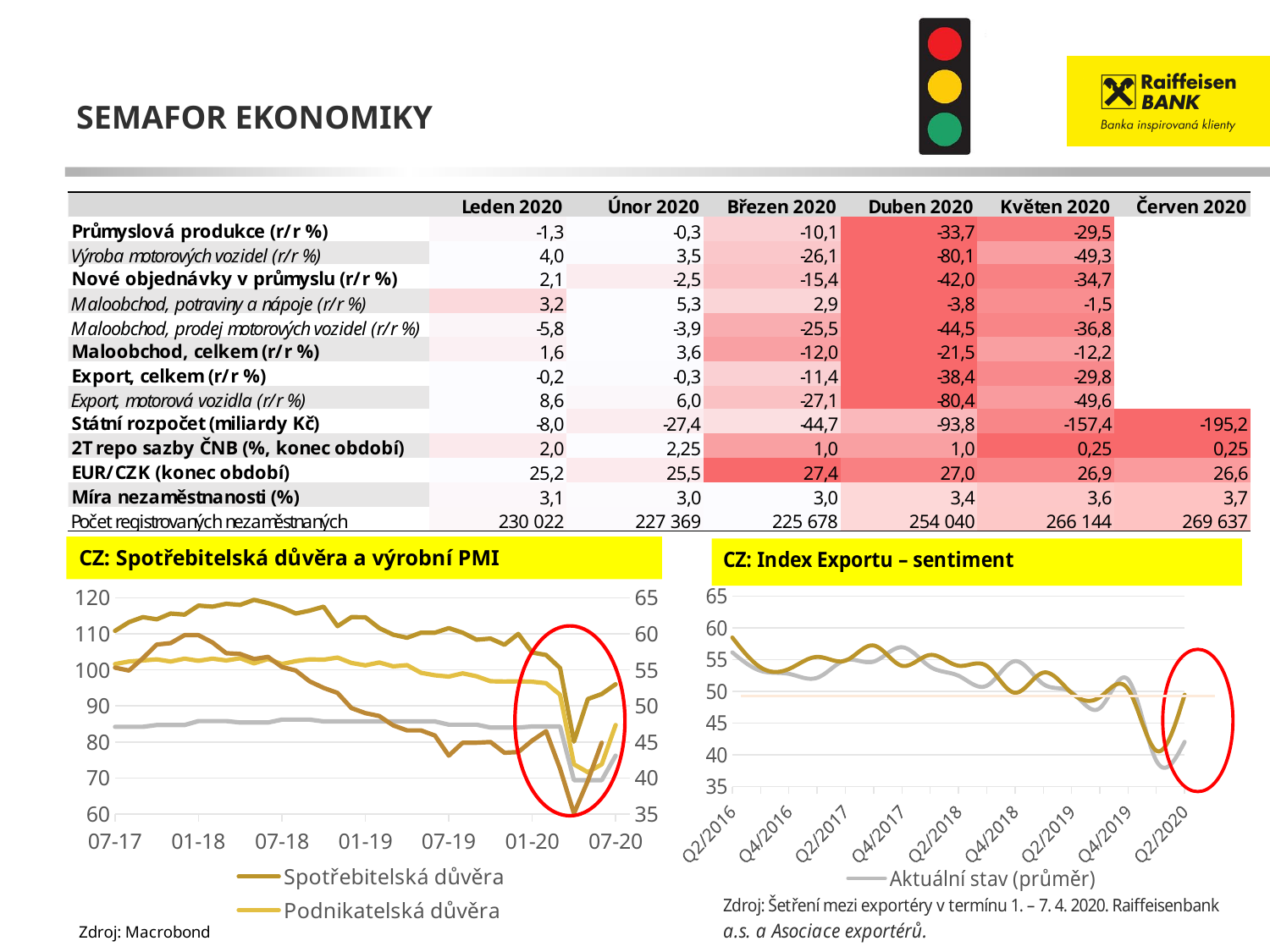
How many x-axis labels are shown in 'CZ: Index Exportu – sentiment'? 9 What kind of chart is 'CZ: Index Exportu – sentiment'? line chart What kind of chart is 'CZ: Spotřebitelská důvěra a výrobní PMI'? line chart In 'CZ: Spotřebitelská důvěra a výrobní PMI', does the Spotřebitelská důvěra line rise or fall between 07-18 and 07-19? fall In 'CZ: Index Exportu – sentiment', is the lowest point of the line in 2020 greater or less than 45? less How many series does the legend of 'CZ: Spotřebitelská důvěra a výrobní PMI' list? 2 What is the legend entry in the chart 'CZ: Index Exportu – sentiment'? Aktuální stav (průměr) In 'CZ: Index Exportu – sentiment', does the line rise or fall between Q4/2019 and the start of 2020? fall How many series does the legend of 'CZ: Index Exportu – sentiment' list? 1 How many x-axis labels are shown in 'CZ: Spotřebitelská důvěra a výrobní PMI'? 7 In 'CZ: Index Exportu – sentiment', is the value at Q2/2016 greater or less than 55? greater What is the source given under the chart 'CZ: Spotřebitelská důvěra a výrobní PMI'? Macrobond